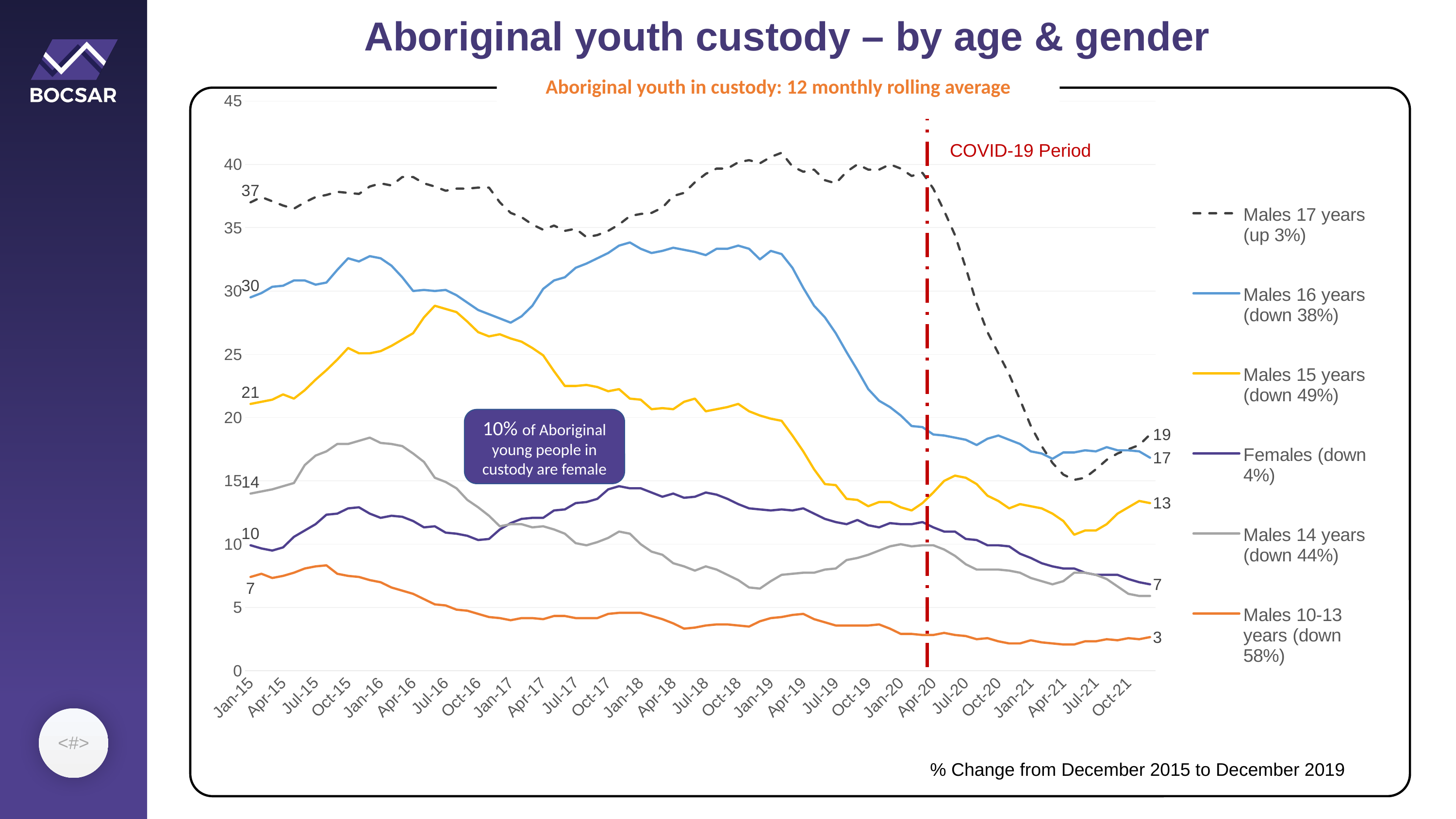
Which series has the highest value at the start of the series (Jan-15)? Males 17 years Which series has the lowest value at the end of the series? Males 10-13 years What is the value for Females at the start of the series (Jan-15)? 10 Is the value for Males 17 years at Apr-21 greater or less than 20? less At the start of the series (Jan-15), which is larger: Males 15 years or Males 14 years? Males 15 years What is the value for Males 16 years at the end of the series (Oct-21 onward)? 17 What is the value for Males 10-13 years at the end of the series? 3 By how much did the Males 16 years value fall from its labelled start value (30) to its labelled end value (17)? 13 How many series does the legend list? 6 According to the legend, what is the percentage change for Males 15 years? down 49% What is the value for Males 17 years at the start of the series (Jan-15)? 37 What kind of chart is shown on the slide? line chart